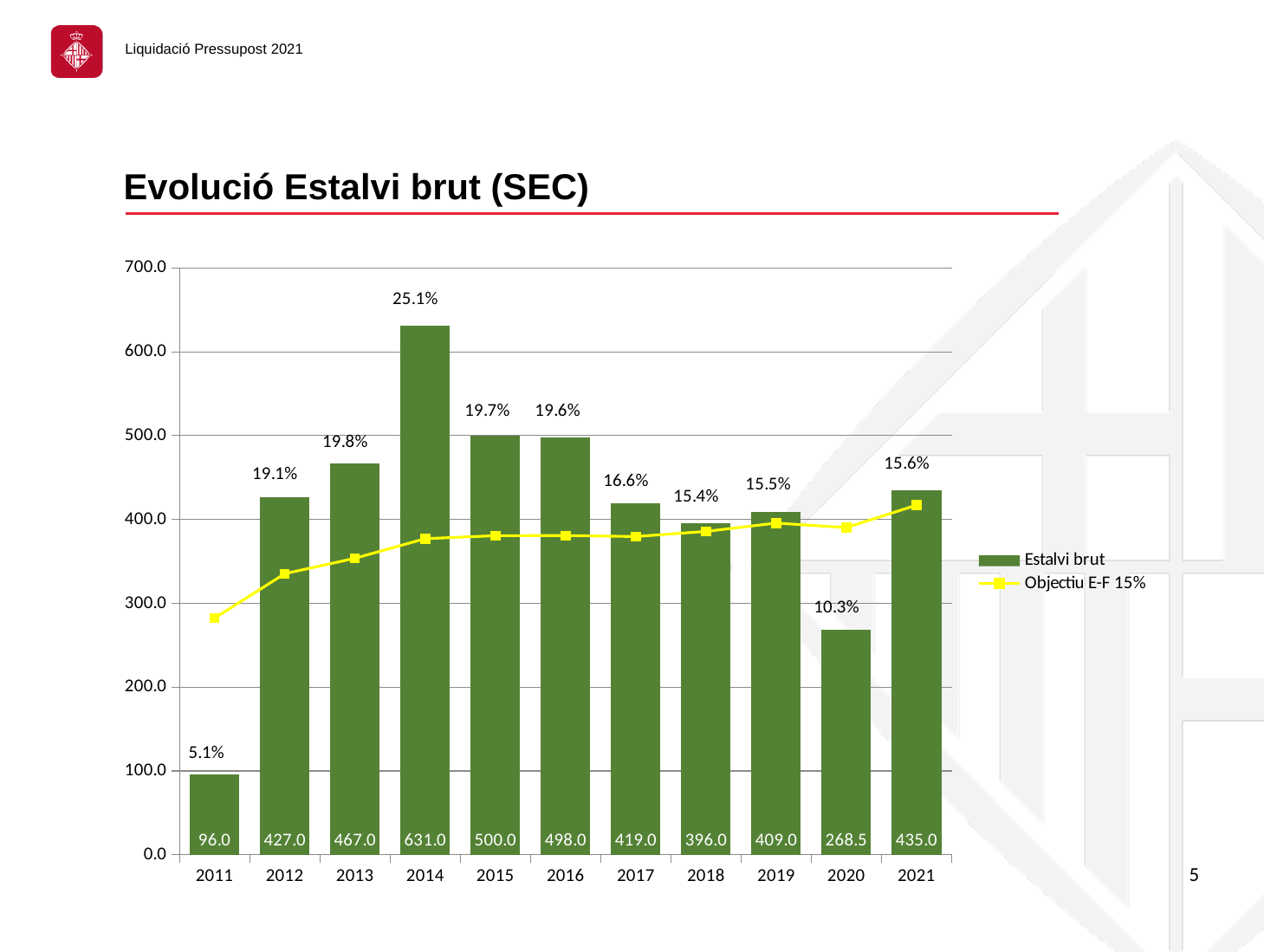
Which is larger, the Estalvi brut value for 2015 or for 2016? 2015 What is the title of the chart? Evolució Estalvi brut (SEC) How many years are shown on the x axis? 11 How many series does the legend list? 2 Which year has the highest Estalvi brut value? 2014 What percentage is shown above the 2021 bar? 15.6% What is the Estalvi brut value for 2014? 631.0 What is the difference between the Estalvi brut values for 2021 and 2020? 166.5 Which year has the lowest Estalvi brut value? 2011 What kind of chart is used for the Estalvi brut series? bar chart What is the Estalvi brut value for 2020? 268.5 Is the Objectiu E-F 15% value for 2011 greater or less than 300.0? less